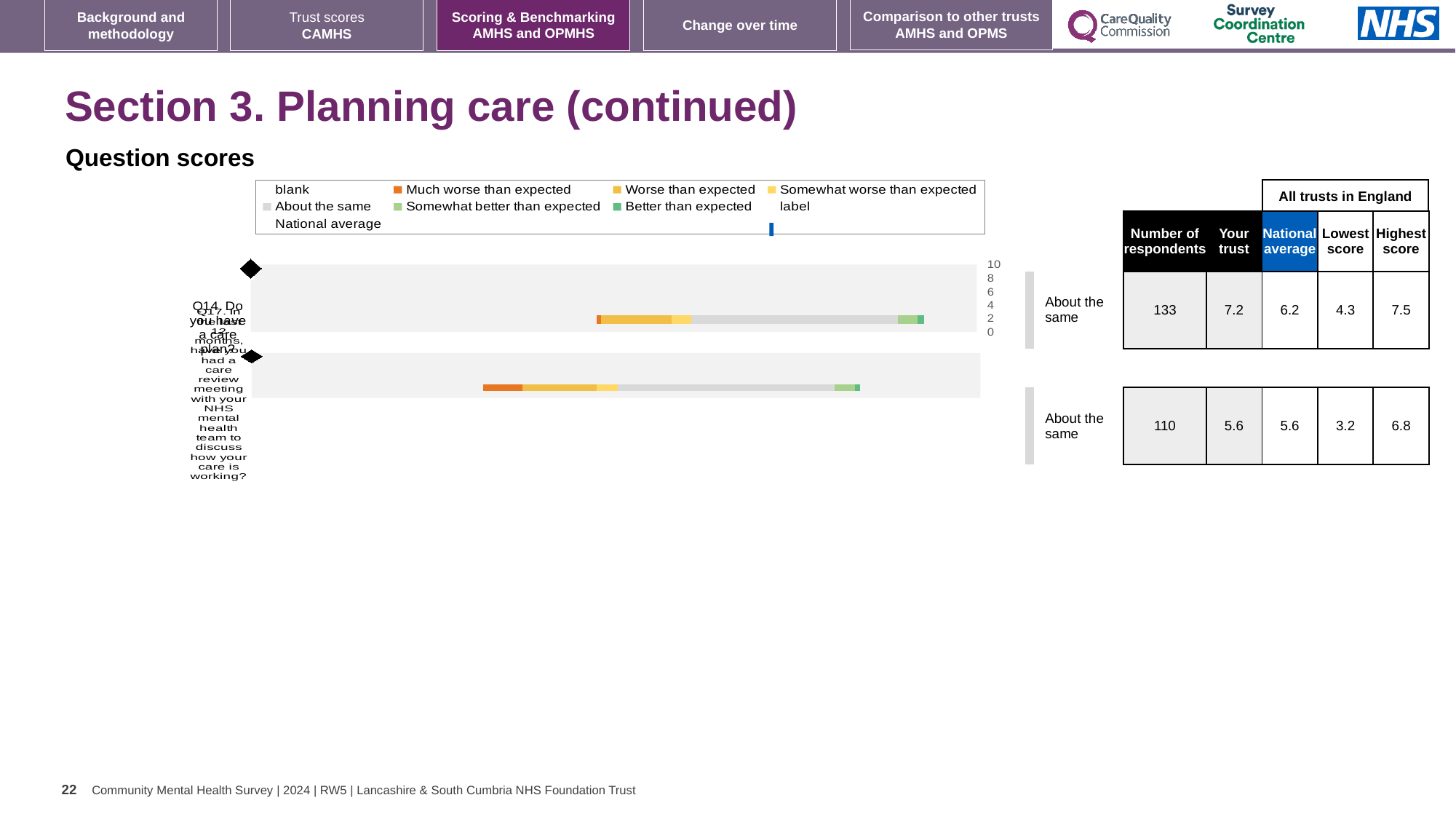
Which question has the higher 'Your trust' score, Q14 or Q17? Q14 Which colour in the legend represents 'Much worse than expected'? orange What kind of chart is used to show the question scores on this slide? bar chart What is the lowest score among all trusts in England for Q14? 4.3 What is the difference between the highest and lowest scores for Q17? 3.6 How many questions (categories) are plotted in the question scores chart? 2 What benchmark category is shown for Q17? About the same By how much does the trust's score for Q14 exceed the national average for Q14? 1.0 How many respondents are shown for Q14 (Do you have a care plan?)? 133 What is the 'Your trust' score for Q14? 7.2 What is the highest score among all trusts in England for Q17? 6.8 What is the national average score for Q17 (care review meeting in the last 12 months)? 5.6